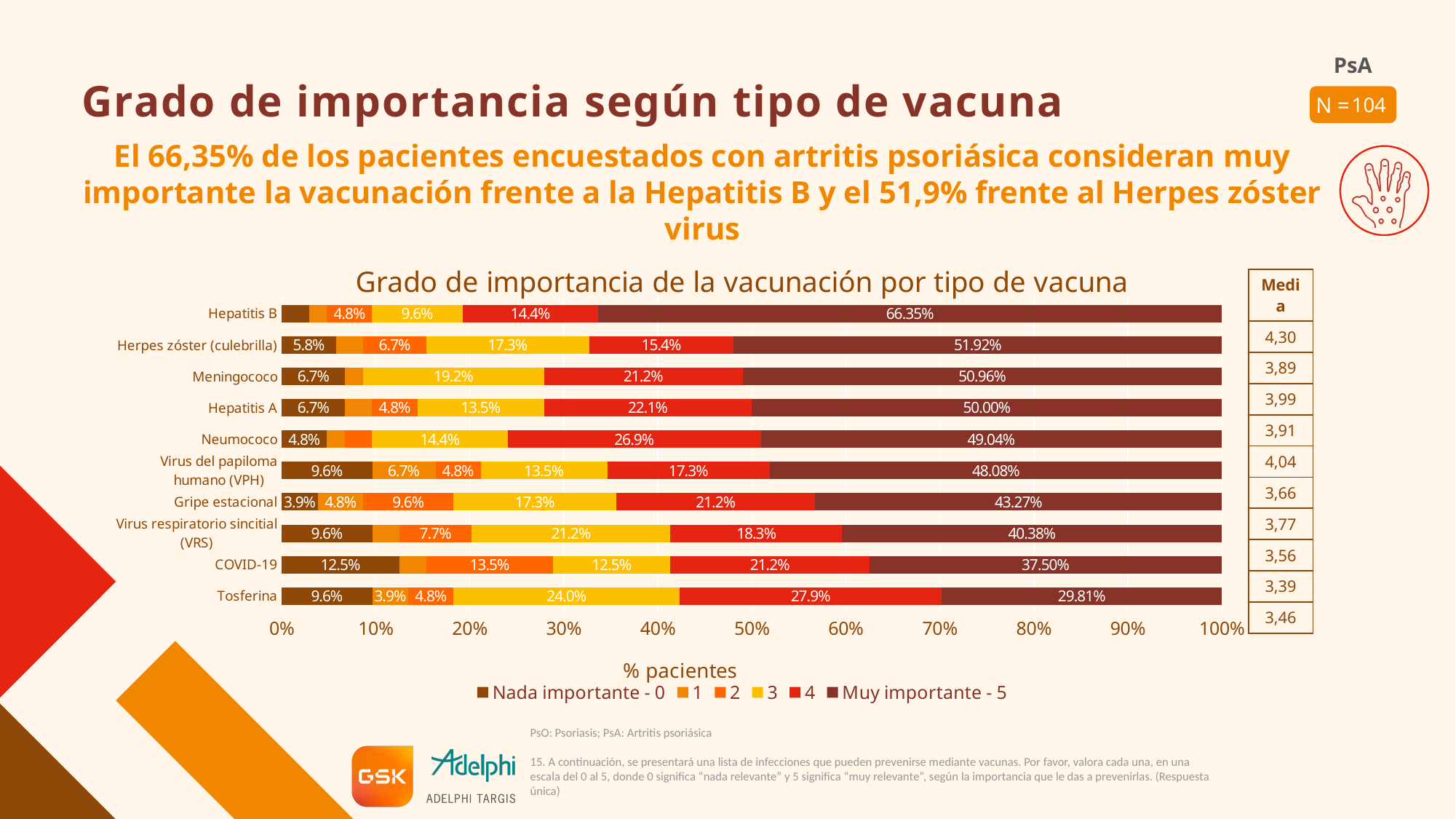
What is the difference between the "Muy importante - 5" values for Hepatitis B and Tosferina? 36.54 percentage points Which has a larger "Muy importante - 5" value: COVID-19 or Virus respiratorio sincitial (VRS)? Virus respiratorio sincitial (VRS) Which vaccine type has the highest share of "Muy importante - 5" responses? Hepatitis B What is the title of the horizontal axis of the chart? % pacientes What is the value of series "3" for Tosferina? 24.0% What kind of chart is shown on the slide? Stacked bar chart What is the value of series "4" for Neumococo? 26.9% What percentage of patients rated Hepatitis B vaccination as "Muy importante - 5"? 66.35% How many vaccine types are shown on the chart? 10 What is the "Nada importante - 0" value for COVID-19? 12.5% How many series does the legend list? 6 Which vaccine type has the lowest share of "Muy importante - 5" responses? Tosferina